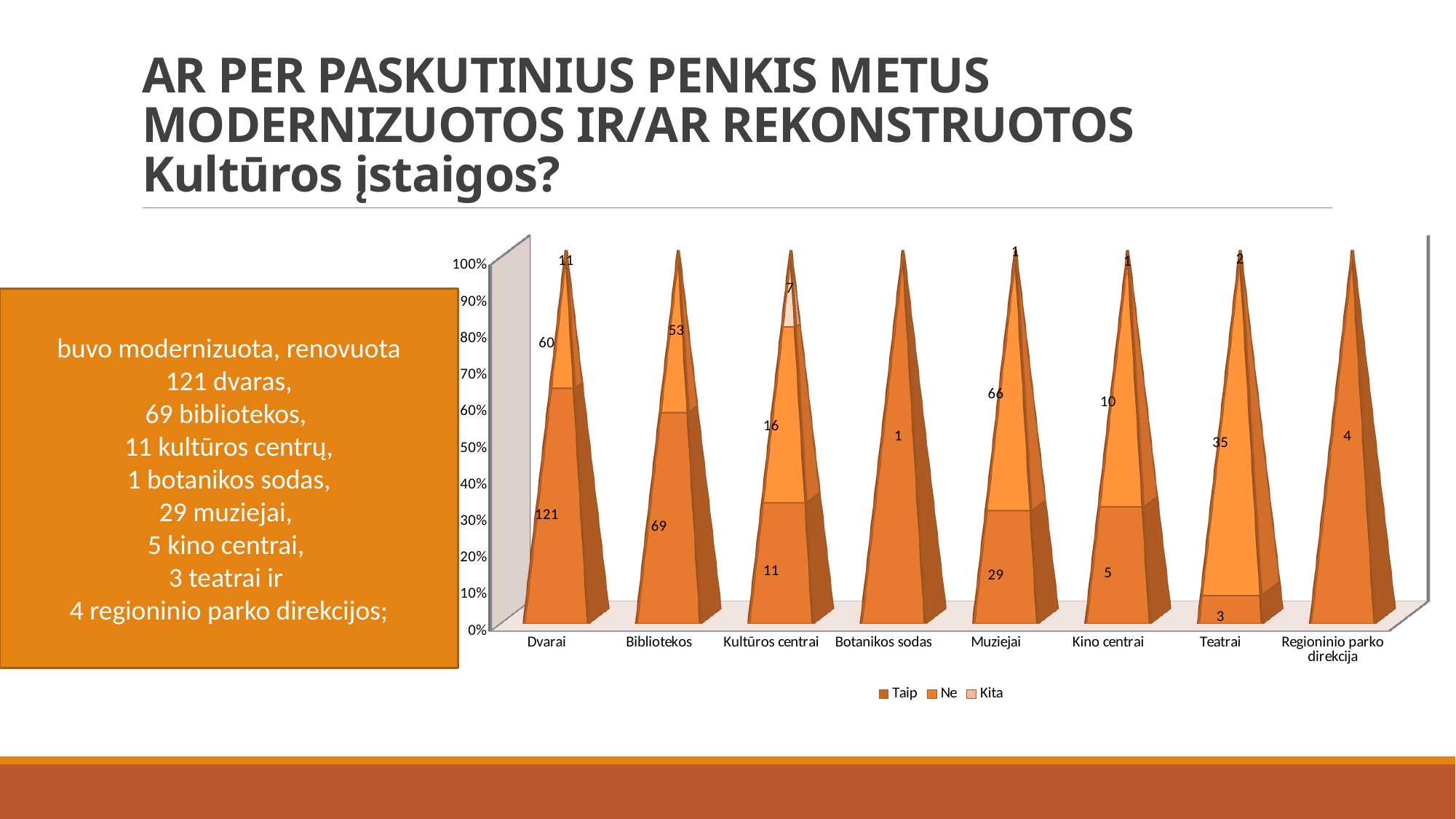
What is the Ne value for Teatrai? 35 How many categories are shown on the x axis? 8 What is the Taip value for Dvarai? 121 How many series does the legend list? 3 Which is larger for Bibliotekos, the Taip value or the Ne value? Taip Which category has the lowest Taip value? Botanikos sodas What kind of chart is shown on the slide? Stacked bar chart What is the Ne value for Muziejai? 66 Which category has the highest Taip value? Dvarai What is the difference between the Taip and Ne values for Dvarai? 61 What is the Kita value for Kultūros centrai? 7 What is the total of the Taip, Ne and Kita values for Dvarai? 192